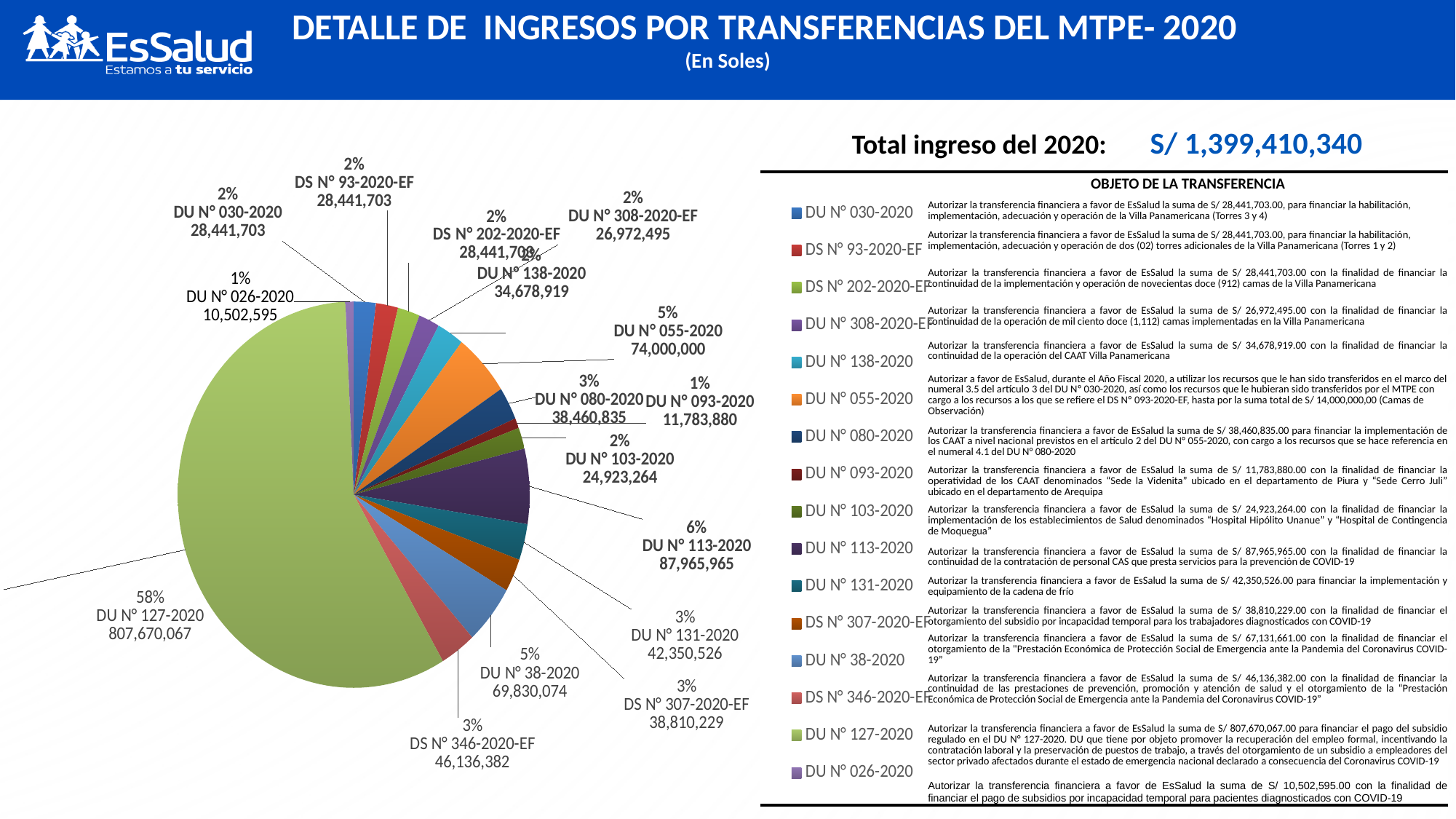
How many entries does the legend list? 16 Which category has the largest slice of the pie? DU N° 127-2020 What is the difference between the values for DU N° 131-2020 and DS N° 307-2020-EF? 3,540,297 What is the value shown for DU N° 113-2020? 87,965,965 Which is larger, the value for DU N° 138-2020 or the value for DU N° 308-2020-EF? DU N° 138-2020 What is the value shown for DU N° 055-2020? 74,000,000 What is the title of the slide? DETALLE DE INGRESOS POR TRANSFERENCIAS DEL MTPE- 2020 What share of the pie does DU N° 38-2020 represent? 5% How many slices does the pie chart have? 16 What kind of chart is shown on the slide? pie chart What share of the pie does DU N° 127-2020 represent? 58% Which category has the smallest value in the pie chart? DU N° 026-2020